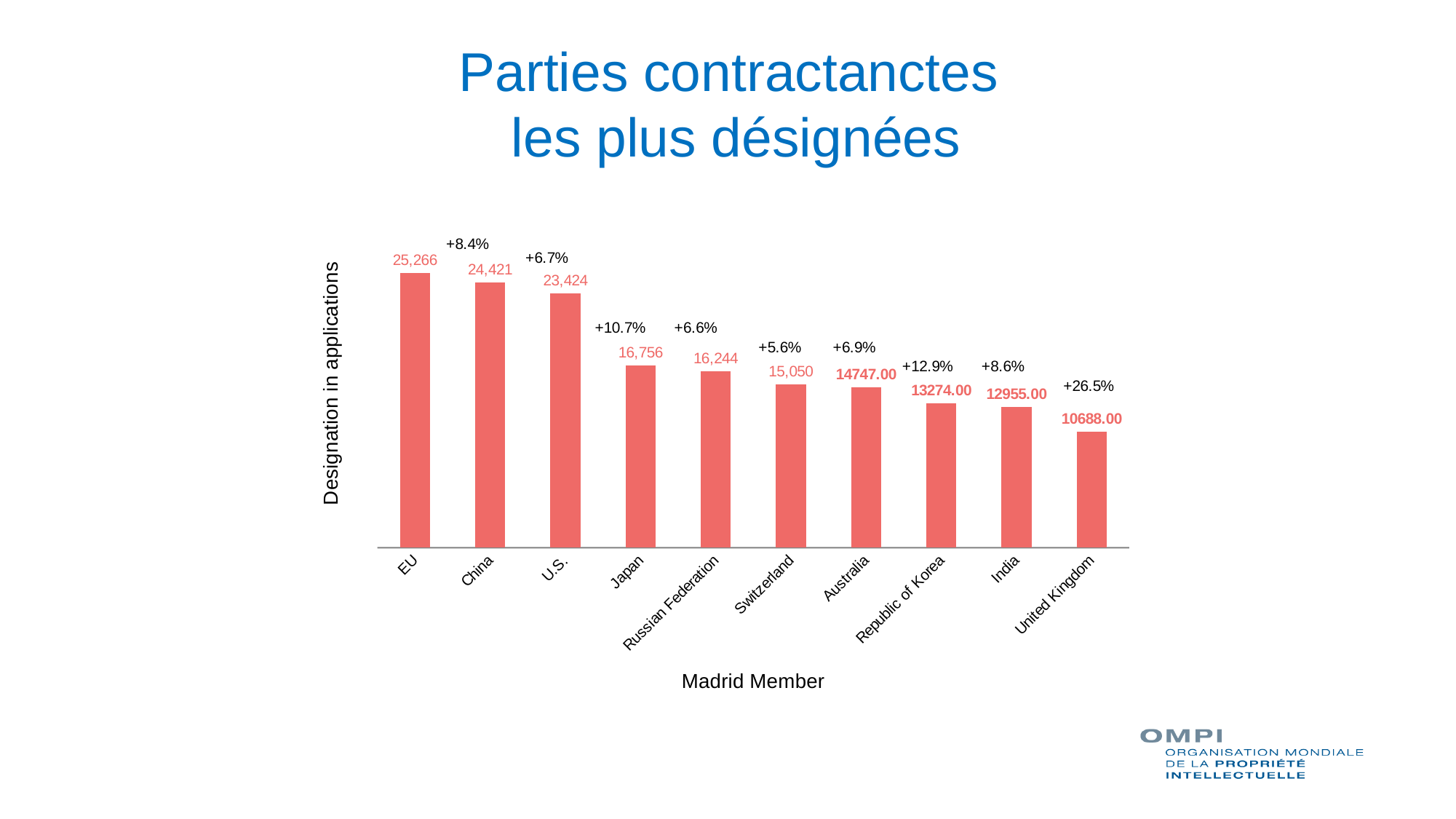
What is the number of designations in applications for Japan? 16,756 Do the values rise or fall from left to right along the x axis? fall What is the value shown for Australia? 14747.00 What kind of chart is shown on the slide? bar chart What is the difference between the values for the EU and China? 845 Which has more designations in applications, Switzerland or the Russian Federation? Russian Federation Which Madrid member has the highest number of designations in applications? EU What is the label of the y axis? Designation in applications What is the value shown for the United Kingdom? 10688.00 What is the number of designations in applications for the EU? 25,266 How many Madrid members are shown on the chart? 10 Which Madrid member has the lowest number of designations in applications? United Kingdom